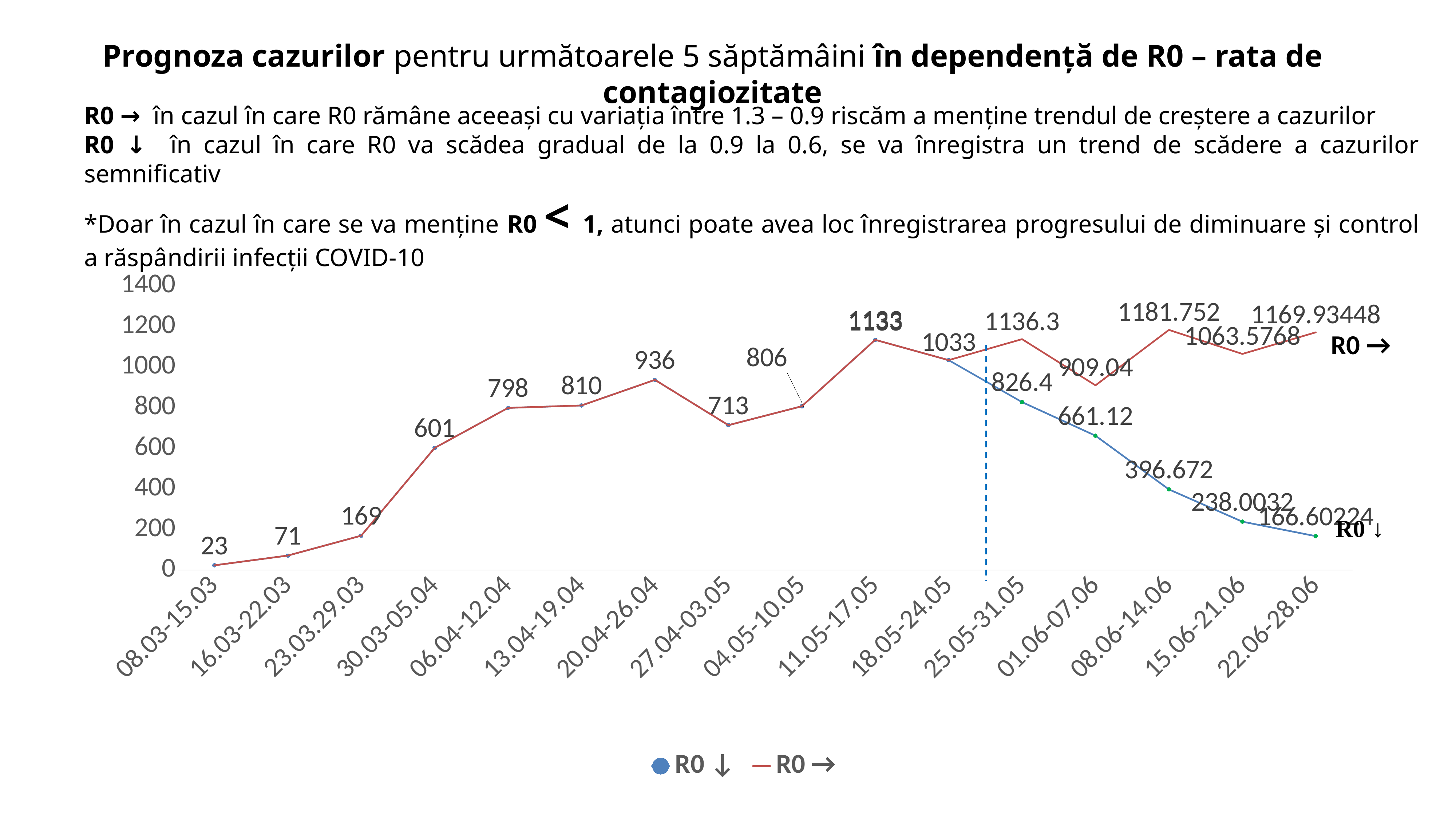
How many series does the legend list? 2 What is the difference between the values for 11.05-17.05 and 18.05-24.05? 100 How many weeks are shown on the x axis? 16 What is the value of the R0 → series for the week 08.06-14.06? 1181.752 What is the value of the R0 ↓ series for the week 22.06-28.06? 166.60224 For the week 25.05-31.05, which series has the larger value, R0 → or R0 ↓? R0 → Which week has the highest value in the R0 → series? 08.06-14.06 What is the value for the week 30.03-05.04? 601 Which week has the lowest value on the chart? 08.03-15.03 What is the difference between the values for 20.04-26.04 and 13.04-19.04? 126 What kind of chart is shown on the slide? line chart Does the R0 ↓ series rise or fall from 25.05-31.05 to 22.06-28.06? fall